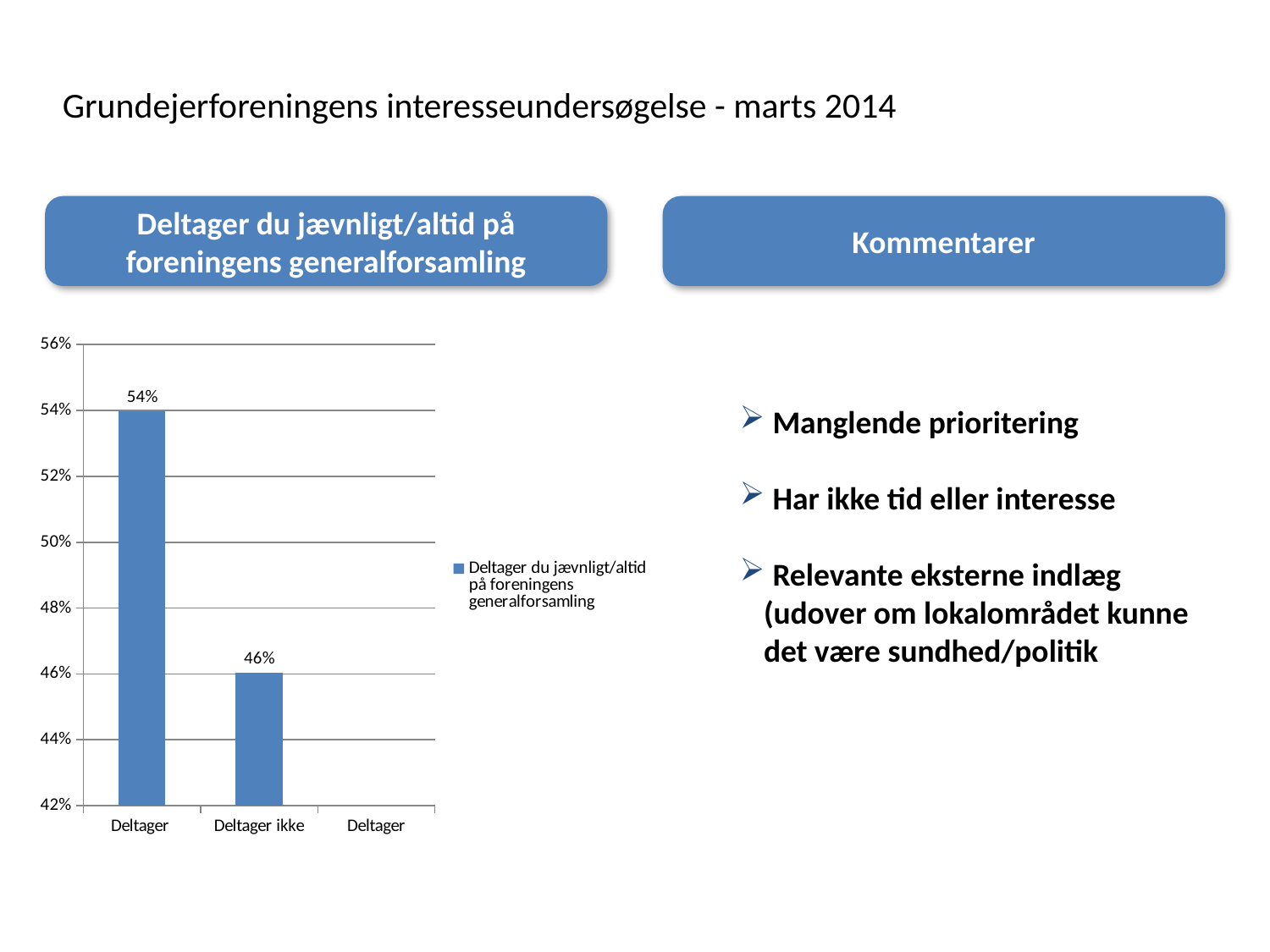
What is the difference between the values for "Deltager" and "Deltager ikke"? 8% What kind of chart is shown on the slide? bar chart What is the value for "Deltager" in the chart? 54% How many bars are plotted in the chart? 2 What is the value for "Deltager ikke" in the chart? 46% Which category has the highest value in the chart? Deltager Which category has the lowest plotted value in the chart? Deltager ikke Which is larger, the value for "Deltager" or the value for "Deltager ikke"? Deltager Is the value for "Deltager ikke" greater or less than 50%? less Is the value for "Deltager" greater or less than 50%? greater How many series does the chart legend list? 1 What is the legend entry of the chart? Deltager du jævnligt/altid på foreningens generalforsamling